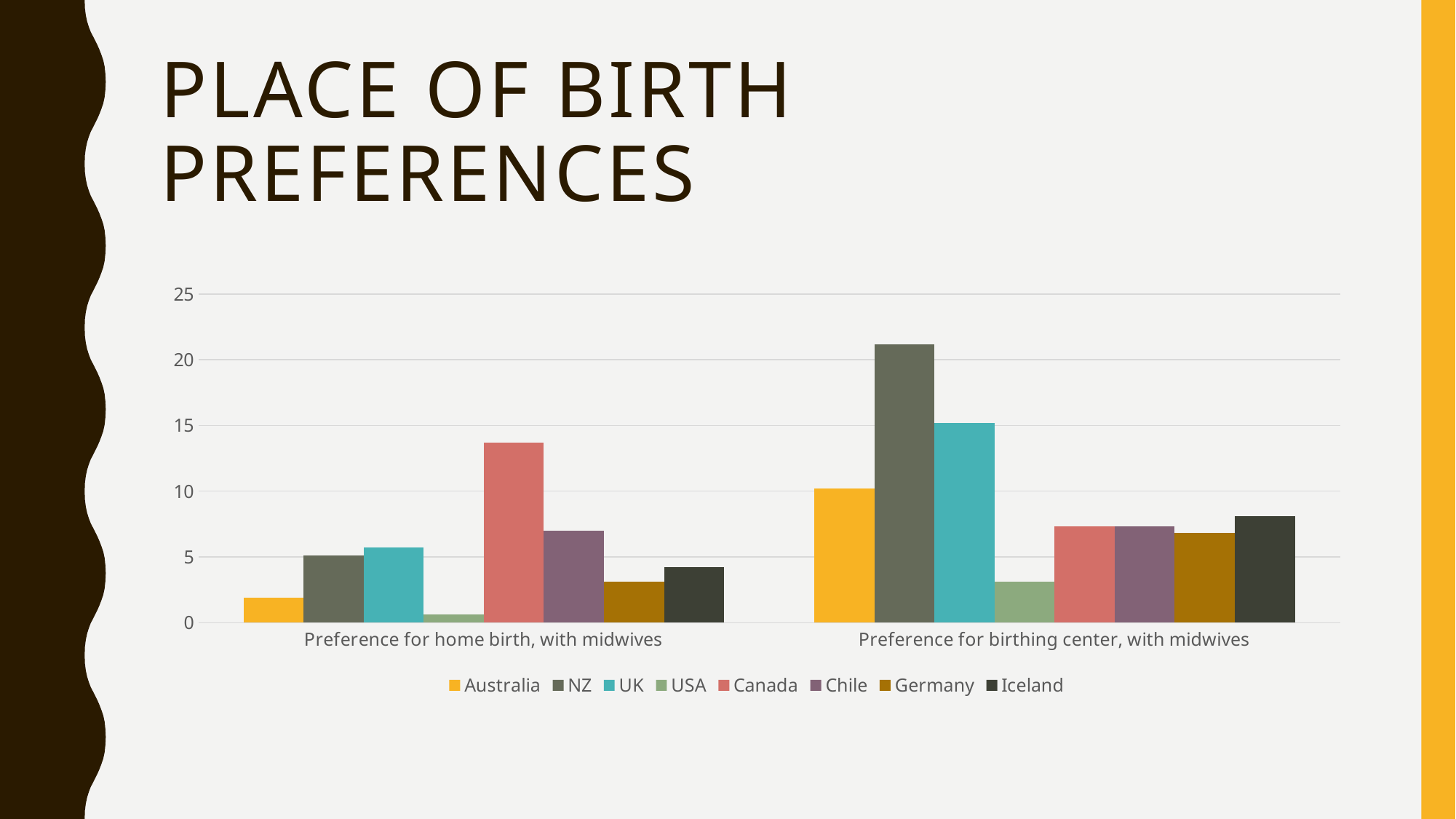
Is the value for Australia in Preference for home birth, with midwives greater or less than 5? less Which country has the highest value for Preference for birthing center, with midwives? NZ Which series is shown in yellow in the legend? Australia Which is larger: the UK value for Preference for birthing center, with midwives or the UK value for Preference for home birth, with midwives? Preference for birthing center, with midwives Which country has the highest value for Preference for home birth, with midwives? Canada What kind of chart is shown on the slide? bar chart Is the value for Canada in Preference for home birth, with midwives greater or less than 10? greater Which country has the lowest value for Preference for birthing center, with midwives? USA How many series does the legend list? 8 Which country has the lowest value for Preference for home birth, with midwives? USA Is the value for NZ in Preference for birthing center, with midwives greater or less than 20? greater How many categories are shown on the x axis? 2